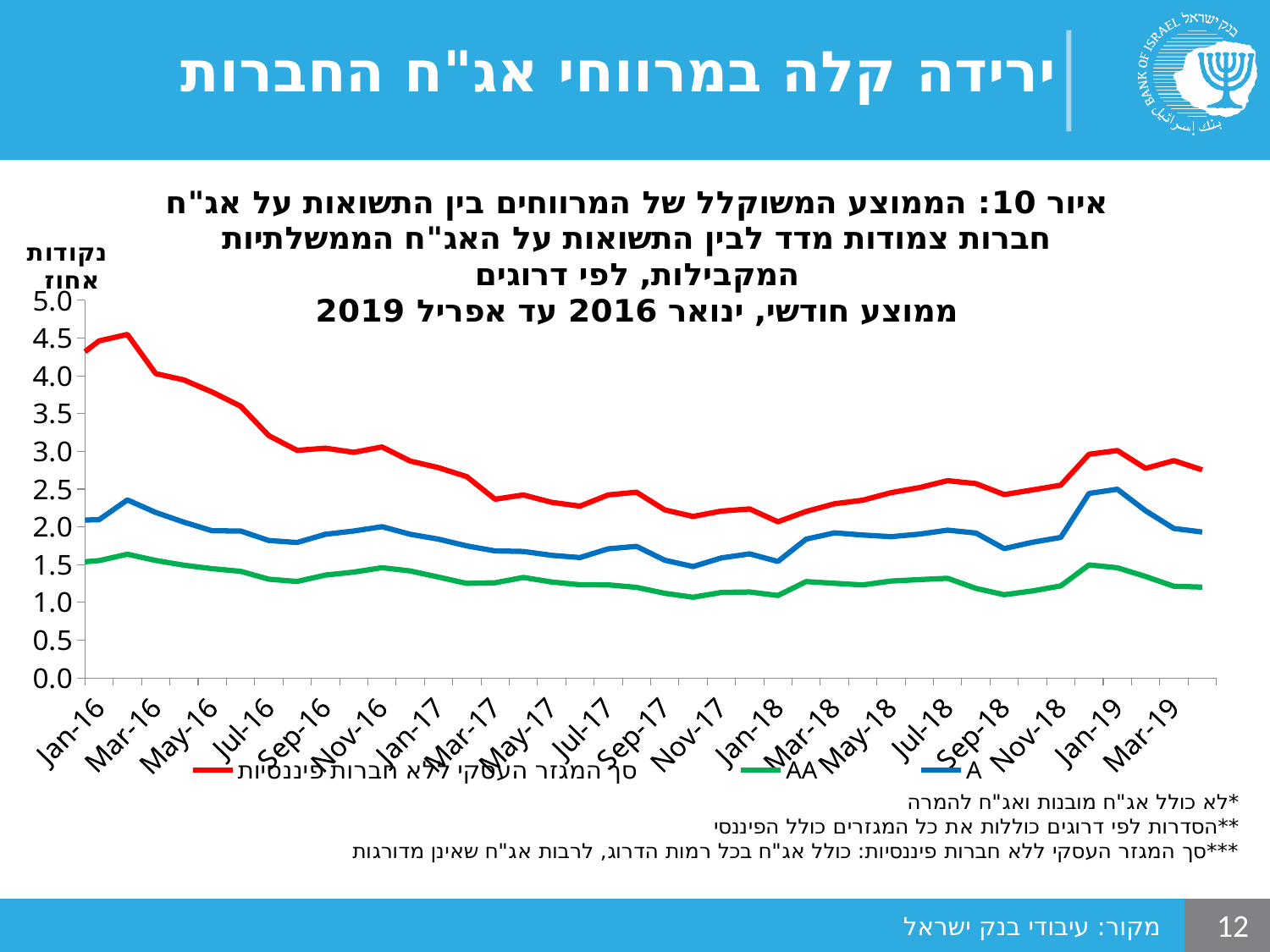
Which series has the highest values across the whole period? סך המגזר העסקי ללא חברות פיננסיות Is the value of the A series at Jan-19 greater or less than 2.0? greater Is the value of the red series (סך המגזר העסקי ללא חברות פיננסיות) at Jan-16 greater or less than 4.0? greater How many series does the legend list? 3 What kind of chart is shown on the slide? line chart Which series has the lowest values across the whole period? AA Is the value of the AA series at Nov-17 greater or less than 1.5? less At Mar-19, which is larger: the A series or the AA series? A What is the highest value shown on the y axis? 5.0 Does the red series (סך המגזר העסקי ללא חברות פיננסיות) rise or fall from Jan-16 to Jan-18? fall What is the unit label shown above the y axis? נקודות אחוז